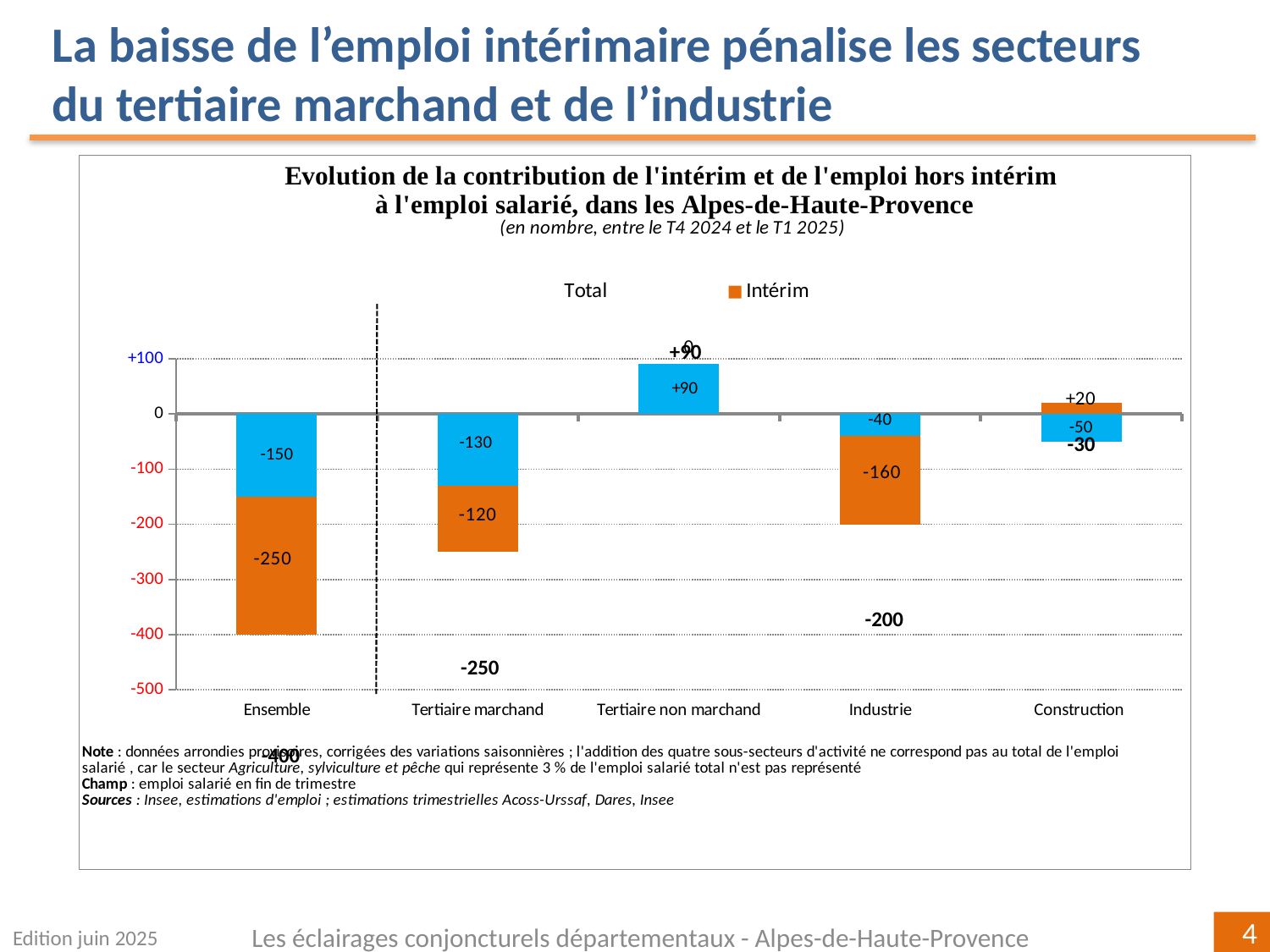
What kind of chart is shown on the slide? Bar chart What is the total value shown for Construction? -30 What is the Intérim value for Industrie? -160 What is the total value shown for Industrie? -200 What is the difference between the Intérim values for Ensemble and Industrie? 90 What is the total value shown for Ensemble? -400 How many categories are shown on the x axis? 5 Which category has the lowest total value? Ensemble What is the value of the blue segment for Tertiaire marchand? -130 What is the Intérim value for Ensemble? -250 Which category has the highest total value? Tertiaire non marchand What is the Intérim value for Construction? +20